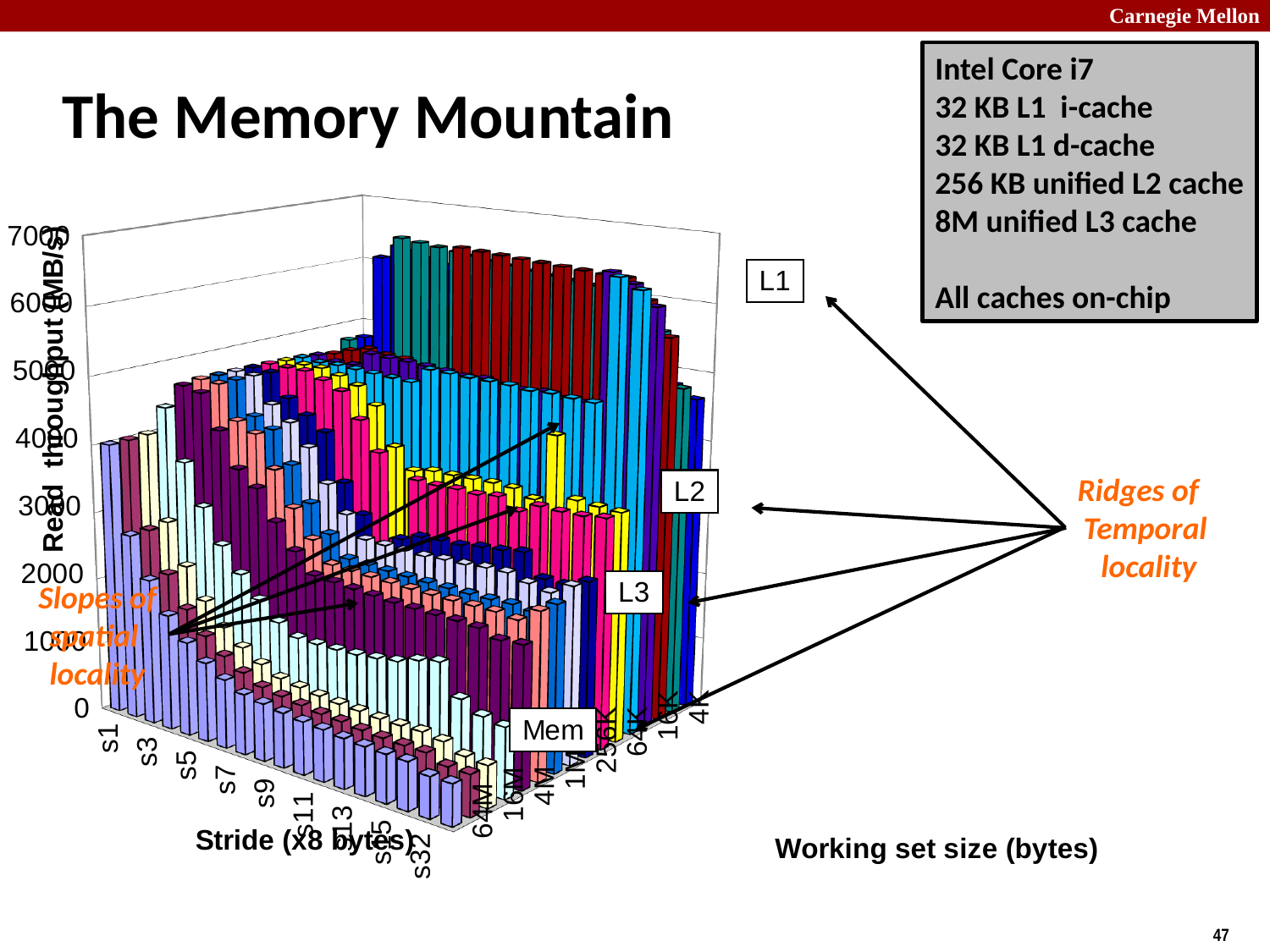
What is the highest tick value shown on the vertical axis of the chart? 7000 Does read throughput rise or fall as the working set size decreases from 64M toward 4K? rise What quantity is plotted on the vertical axis of the chart? Read throughput (MB/s) Is the read throughput of the tallest bars on the L1 ridge greater or less than 5000 MB/s? greater What is the title of the chart on the slide? The Memory Mountain Which cache level is labelled at the highest ridge of the memory mountain? L1 What kind of chart is shown on the slide? 3D bar chart How many working set size labels are shown along the working set size axis? 8 Is the read throughput of the bars in the Mem region at stride s32 greater or less than 2000 MB/s? less Which region label marks the lowest part of the memory mountain? Mem What is the lowest tick value shown on the vertical axis of the chart? 0